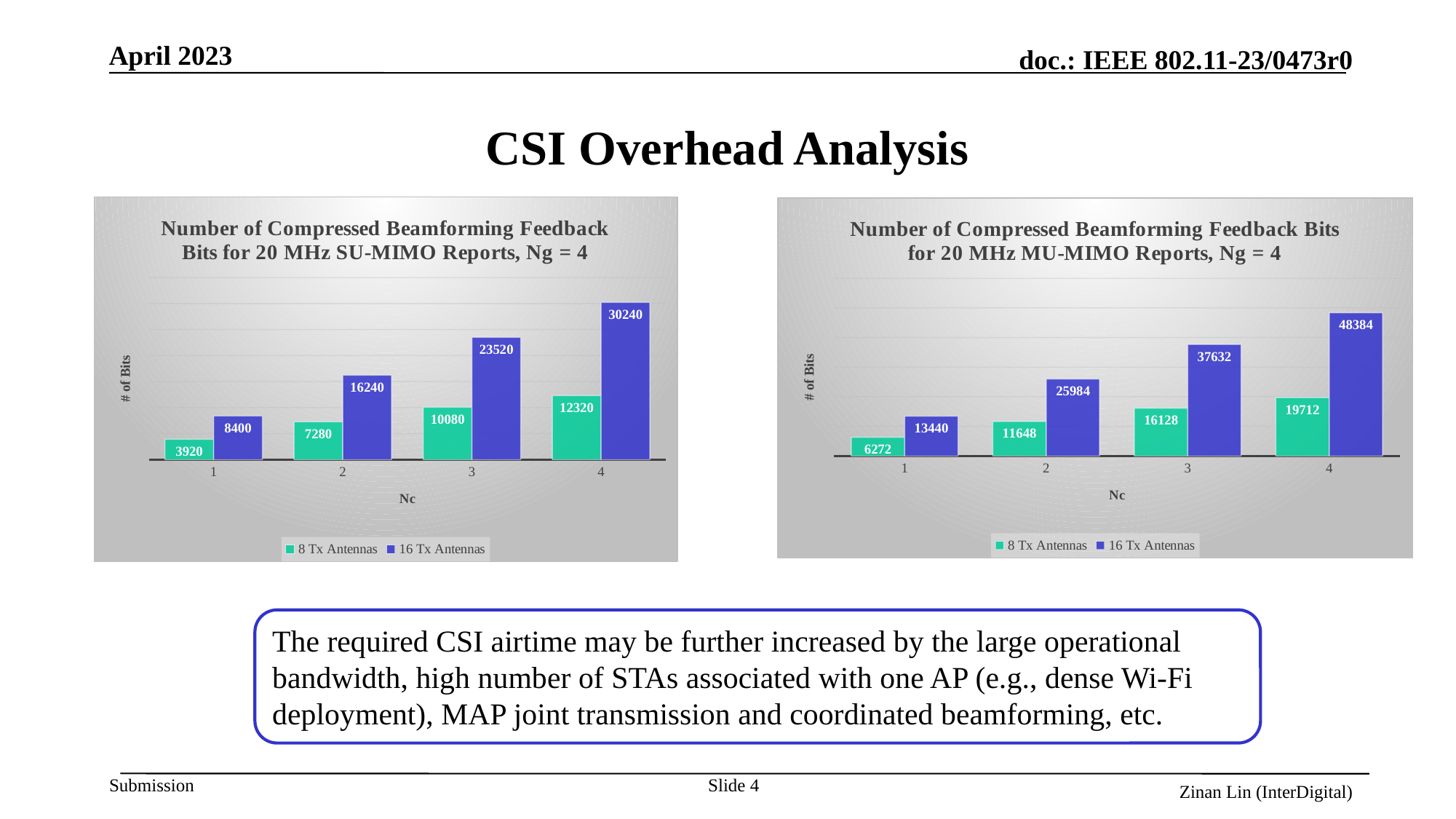
In the MU-MIMO chart (right), what is the difference between the 16 Tx Antennas and 8 Tx Antennas values at Nc = 1? 7168 In the MU-MIMO chart (right), which is larger at Nc = 3: the 8 Tx Antennas value or the 16 Tx Antennas value? 16 Tx Antennas How many series does the legend of the MU-MIMO chart (right) list? 2 In the MU-MIMO chart (right), what is the value for 8 Tx Antennas at Nc = 2? 11648 In the MU-MIMO chart (right), which Nc value has the highest number of bits for 16 Tx Antennas? 4 What type of chart is the SU-MIMO chart on the left? Bar chart In the MU-MIMO chart (right), do the 16 Tx Antennas values rise or fall as Nc increases from 1 to 4? Rise In the SU-MIMO chart (left), what is the value for 16 Tx Antennas at Nc = 3? 23520 In the SU-MIMO chart (left), what is the value for 8 Tx Antennas at Nc = 1? 3920 How many Nc categories are shown on the x axis of the SU-MIMO chart (left)? 4 In the SU-MIMO chart (left), which Nc value has the lowest number of bits for 8 Tx Antennas? 1 In the SU-MIMO chart (left), what is the difference between the 16 Tx Antennas and 8 Tx Antennas values at Nc = 4? 17920